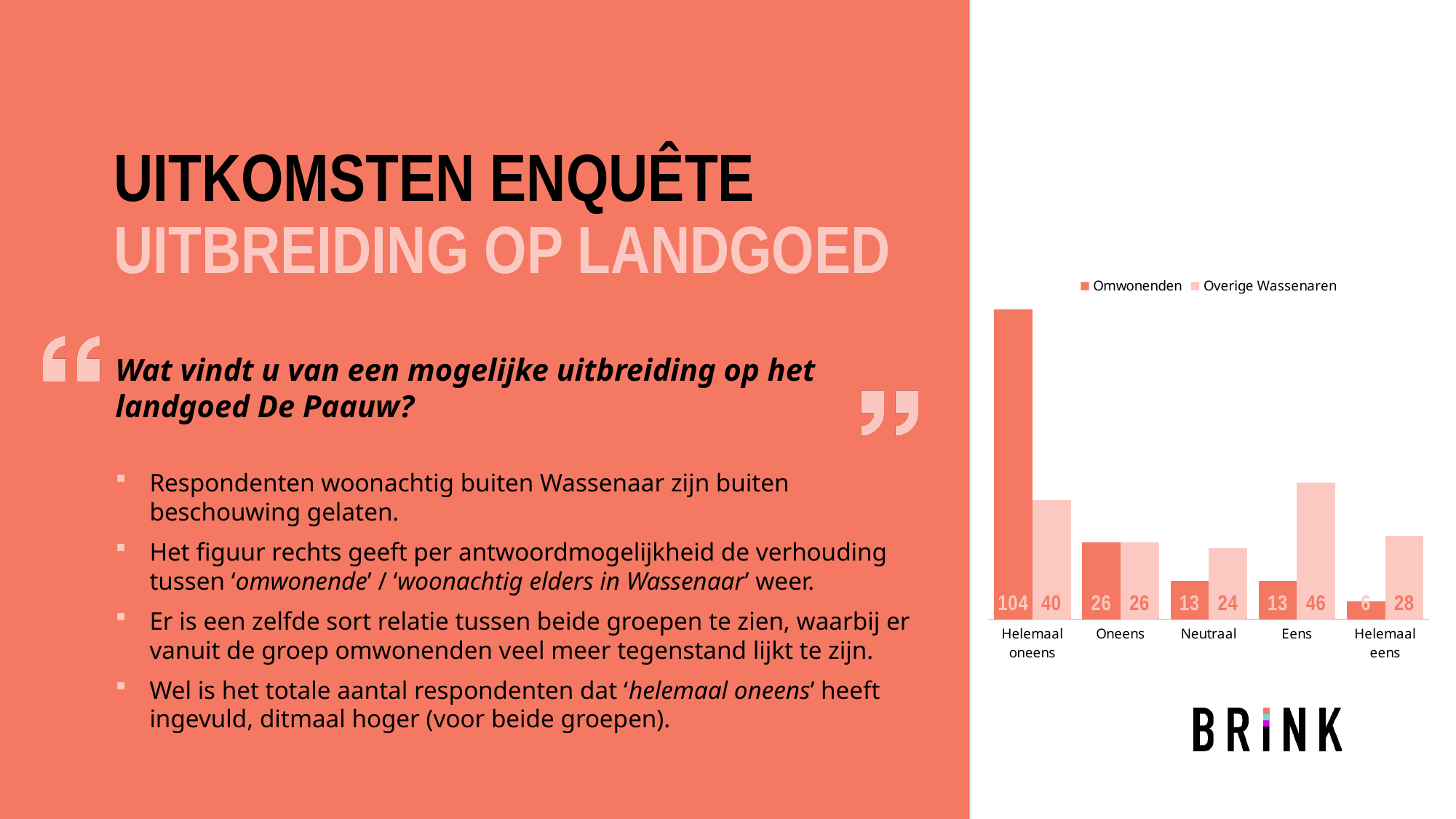
How many series does the legend list? 2 Which category has the highest value for Overige Wassenaren? Eens Which category has the lowest value for Omwonenden? Helemaal eens What kind of chart is shown on the slide? Bar chart In the 'Neutraal' category, which series has the larger value, Omwonenden or Overige Wassenaren? Overige Wassenaren What is the difference between the Omwonenden and Overige Wassenaren values in the 'Helemaal oneens' category? 64 Do the Omwonenden values rise or fall from 'Helemaal oneens' to 'Helemaal eens'? Fall What is the value for Omwonenden in the 'Helemaal eens' category? 6 What is the value for Omwonenden in the 'Helemaal oneens' category? 104 What is the value for Overige Wassenaren in the 'Eens' category? 46 What are the two series named in the chart legend? Omwonenden and Overige Wassenaren How many answer categories are shown on the x axis? 5